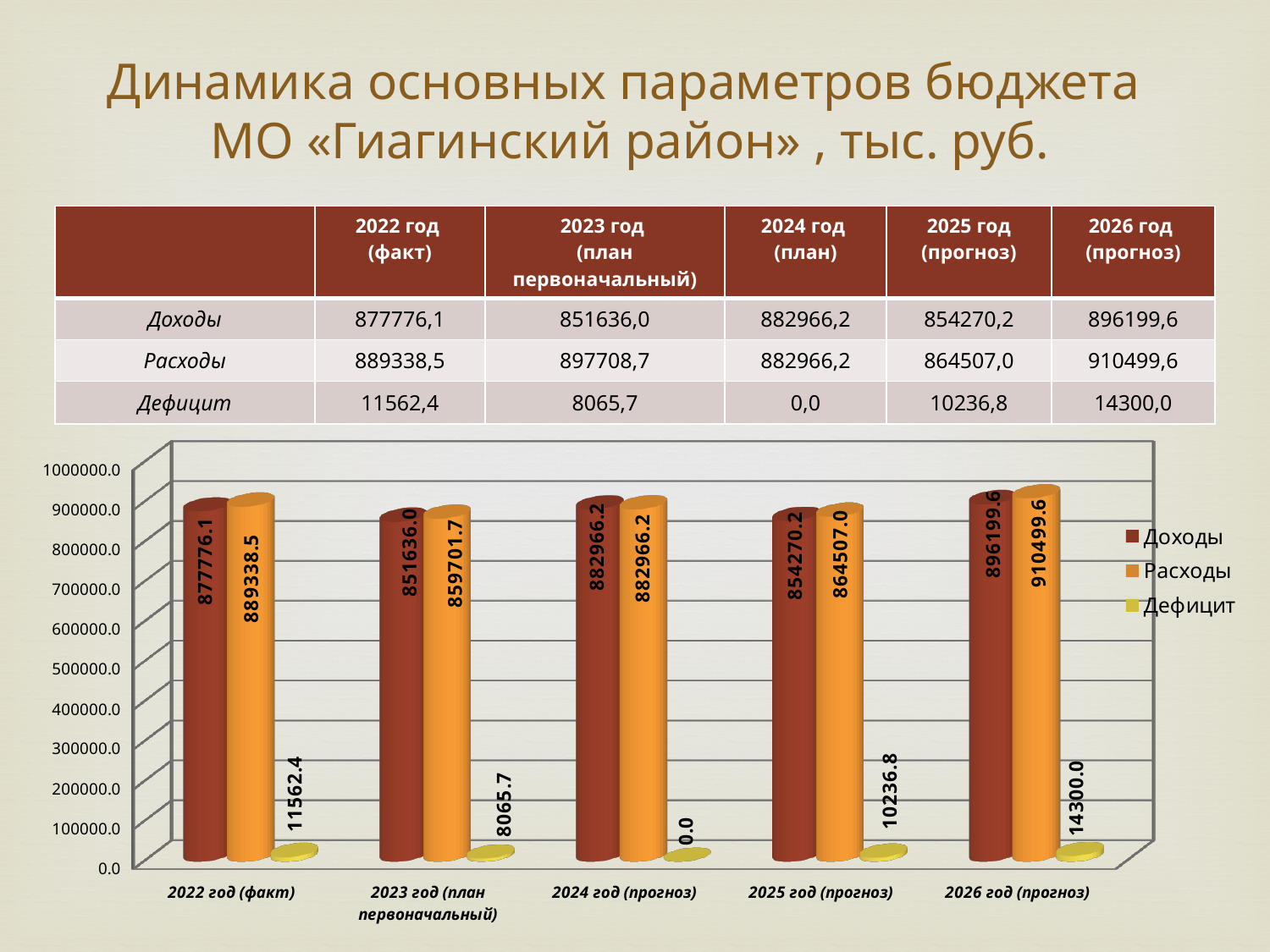
How many series does the chart legend list? 3 How many year categories are shown on the chart's x axis? 5 What is the value of Расходы for 2026 год (прогноз) in the chart? 910499.6 Which is larger in the chart for 2025 год (прогноз): Доходы or Расходы? Расходы In which year category is the Дефицит value lowest in the chart? 2024 год (прогноз) What is the value of Дефицит for 2025 год (прогноз) in the chart? 10236.8 Which series in the chart legend is shown in yellow? Дефицит Is the Доходы value for 2026 год (прогноз) greater or less than 800000.0? greater What is the difference between Расходы and Доходы for 2022 год (факт) in the chart? 11562.4 In which year category is the Дефицит value highest in the chart? 2026 год (прогноз) What is the value of Доходы for 2022 год (факт) in the chart? 877776.1 What type of chart is shown on the slide? bar chart